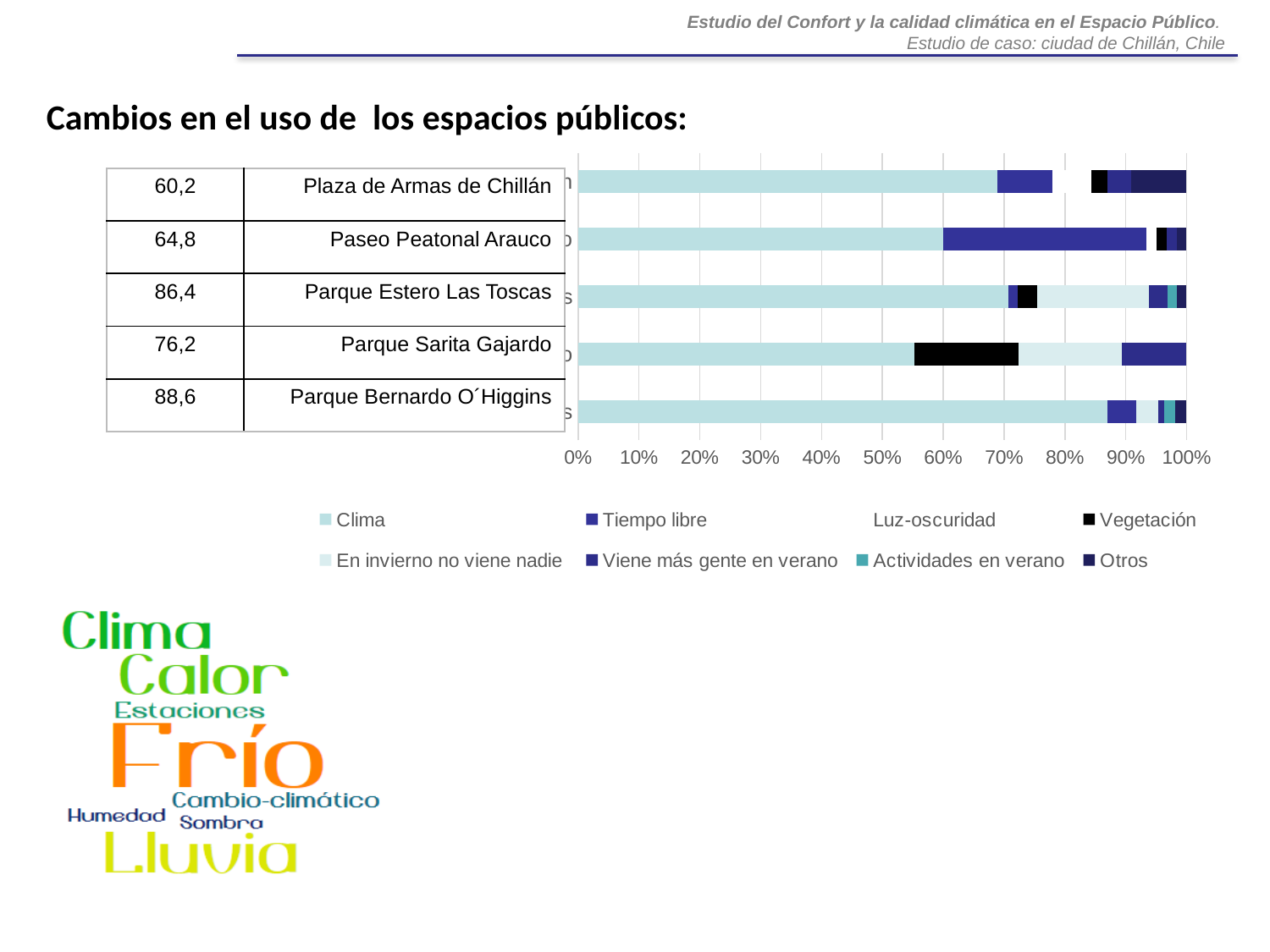
Is the Clima share for Parque Bernardo O´Higgins greater or less than 80%? greater How many series does the chart legend list? 8 Which public space has the largest share for Vegetación? Parque Sarita Gajardo What colour represents the Vegetación series in the chart? Black Is the Clima share for Parque Sarita Gajardo greater or less than 60%? less Which public space has the largest share for Clima? Parque Bernardo O´Higgins How many public spaces (categories) are plotted in the chart? 5 What kind of chart is shown on the slide? Stacked bar chart Which public space has the smallest share for Clima? Parque Sarita Gajardo Is the Clima share for Plaza de Armas de Chillán greater or less than 60%? greater Which has the larger Clima share, Plaza de Armas de Chillán or Parque Sarita Gajardo? Plaza de Armas de Chillán Which public space has the largest share for Tiempo libre? Paseo Peatonal Arauco